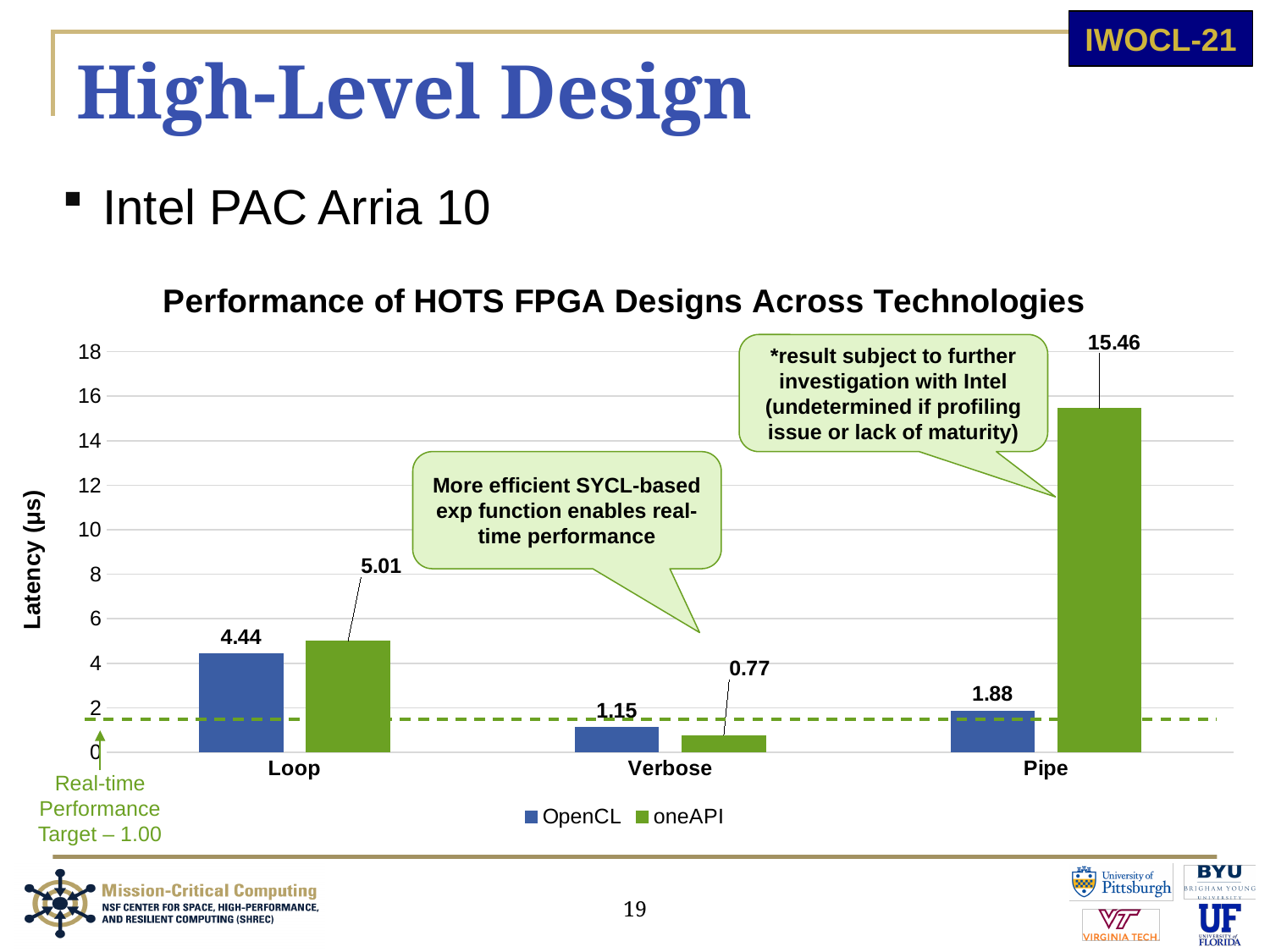
Which design has the highest oneAPI latency? Pipe What is the OpenCL latency for the Loop design? 4.44 What is the difference between the oneAPI and OpenCL latency for the Pipe design? 13.58 How many series does the legend list? 2 Which design has the lowest OpenCL latency? Verbose How many designs are shown on the x axis? 3 What type of chart is shown on the slide? bar chart Is the oneAPI latency for the Pipe design greater or less than 14? greater What is the OpenCL latency for the Pipe design? 1.88 What is the oneAPI latency for the Pipe design? 15.46 What is the oneAPI latency for the Verbose design? 0.77 For the Verbose design, which is larger: the OpenCL latency or the oneAPI latency? OpenCL